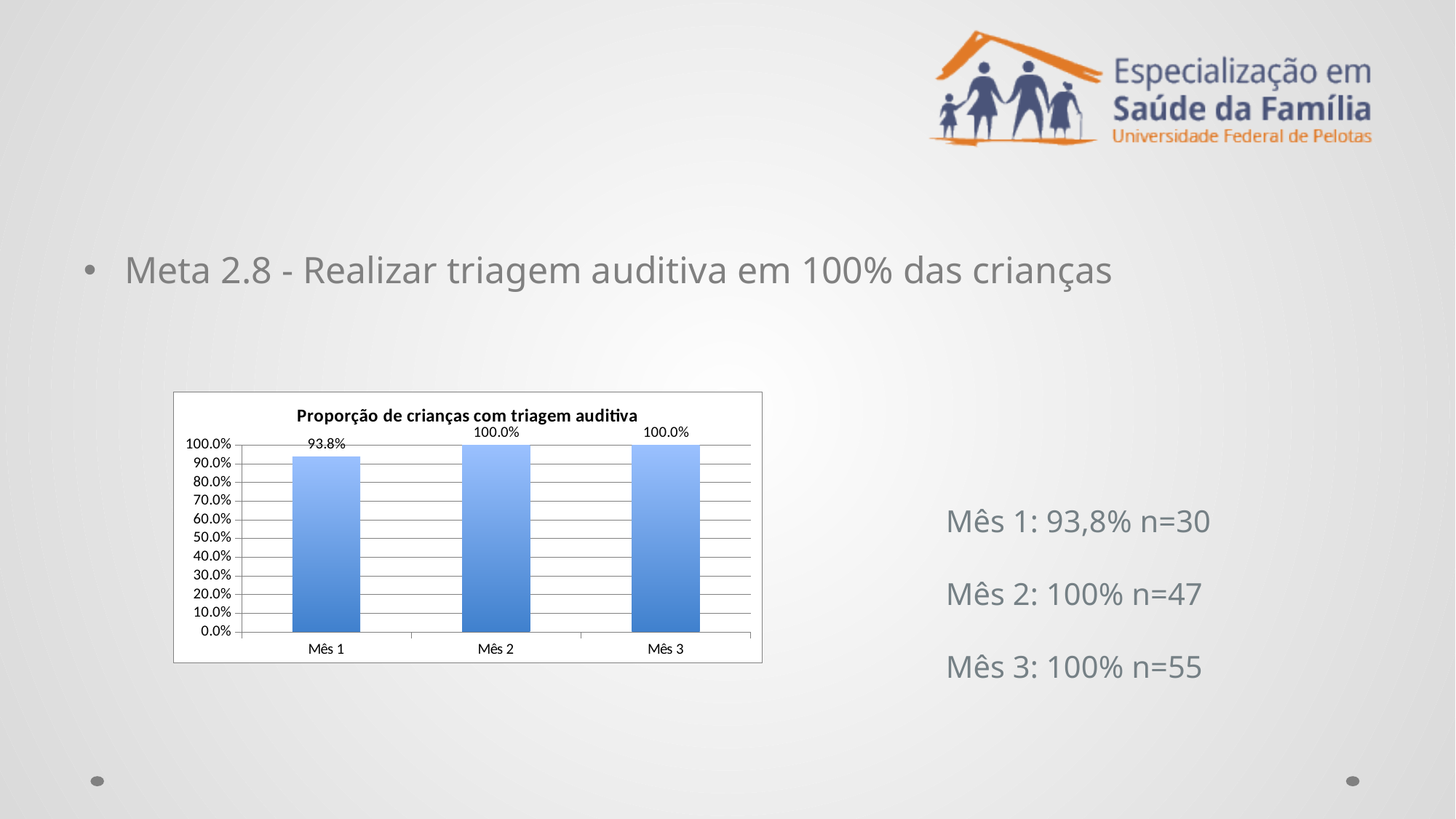
What is the value for Mês 3 in the chart? 100.0% What is the title of the chart? Proporção de crianças com triagem auditiva Do the values rise or fall from Mês 1 to Mês 2? Rise Which is larger, the value for Mês 1 or the value for Mês 3? Mês 3 What kind of chart is shown on the slide? Bar chart Which month has the lowest value in the chart? Mês 1 What is the value for Mês 2 in the chart? 100.0% What is the highest value shown on the y axis of the chart? 100.0% What is the value for Mês 1 in the chart? 93.8% Is the value for Mês 1 greater or less than 90.0%? greater How many months are shown on the x axis of the chart? 3 What is the difference between the values for Mês 2 and Mês 1? 6.2%